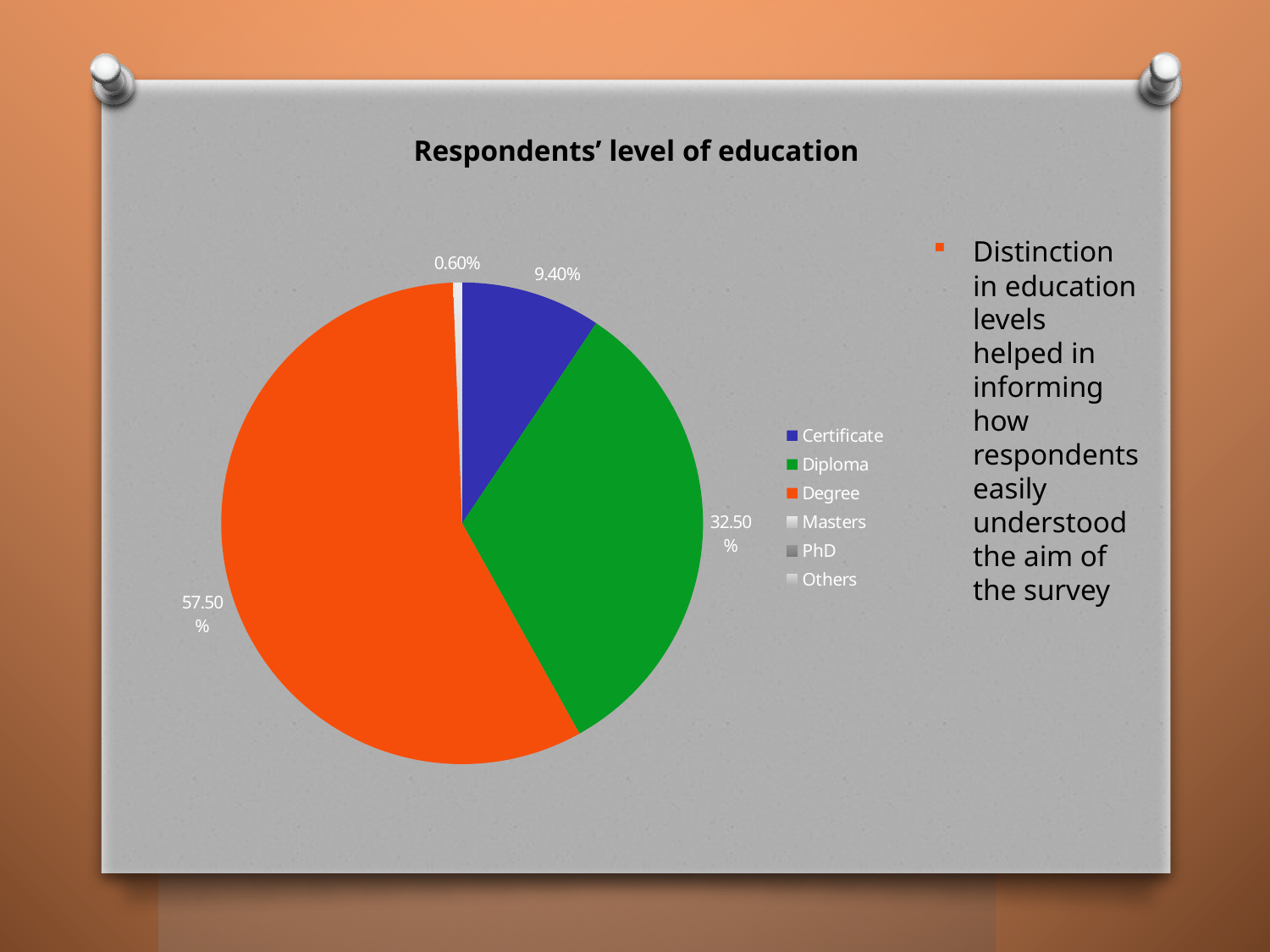
What is the difference between the Diploma share and the Certificate share? 23.10% What percentage of respondents have a Diploma? 32.50% What percentage of respondents have a Certificate? 9.40% What kind of chart is shown on the slide? pie chart What is the title of the chart? Respondents' level of education Which is larger, the share for Diploma or the share for Certificate? Diploma What colour is the Degree slice? orange Which education level has the largest share of respondents? Degree Is the share for Degree greater or less than 50%? greater What is the difference between the Degree share and the Diploma share? 25.00% How many education levels are listed in the legend? 6 What percentage of respondents have a Degree? 57.50%